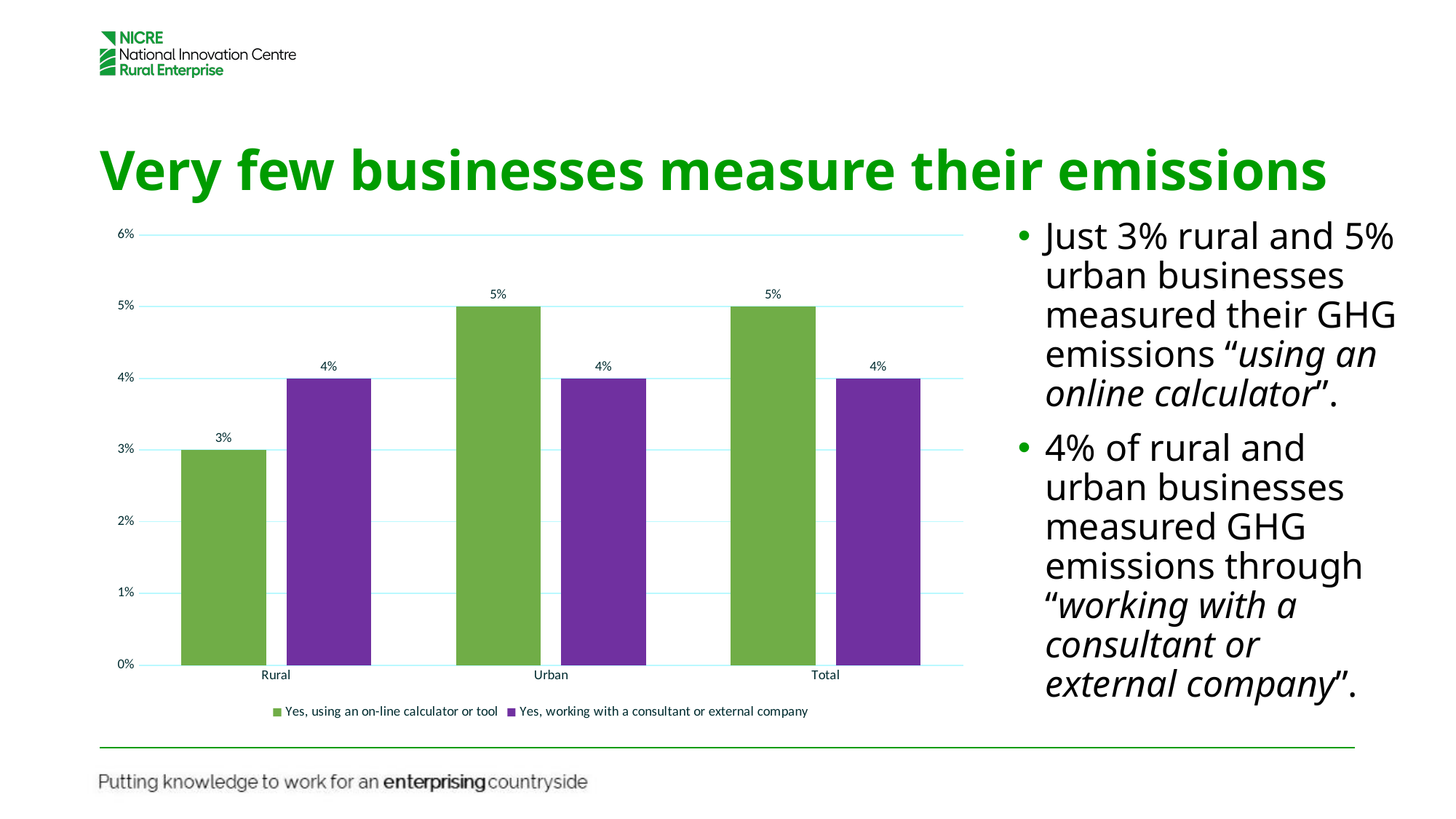
How many series does the chart legend list? 2 For Rural, which series is larger: 'Yes, using an on-line calculator or tool' or 'Yes, working with a consultant or external company'? Yes, working with a consultant or external company What is the Total value for 'Yes, using an on-line calculator or tool'? 5% Does the value for 'Yes, using an on-line calculator or tool' rise or fall from Rural to Urban? Rise What is the difference between the Urban and Rural values for 'Yes, using an on-line calculator or tool'? 2% How many categories are shown on the x axis of the chart? 3 Which category has the lowest value for 'Yes, using an on-line calculator or tool'? Rural What percentage of urban businesses measured their emissions by working with a consultant or external company? 4% What colour are the bars for 'Yes, working with a consultant or external company'? Purple What kind of chart is shown on the slide? Bar chart What percentage of rural businesses measured their emissions using an on-line calculator or tool? 3% For Urban, which series is larger: 'Yes, using an on-line calculator or tool' or 'Yes, working with a consultant or external company'? Yes, using an on-line calculator or tool